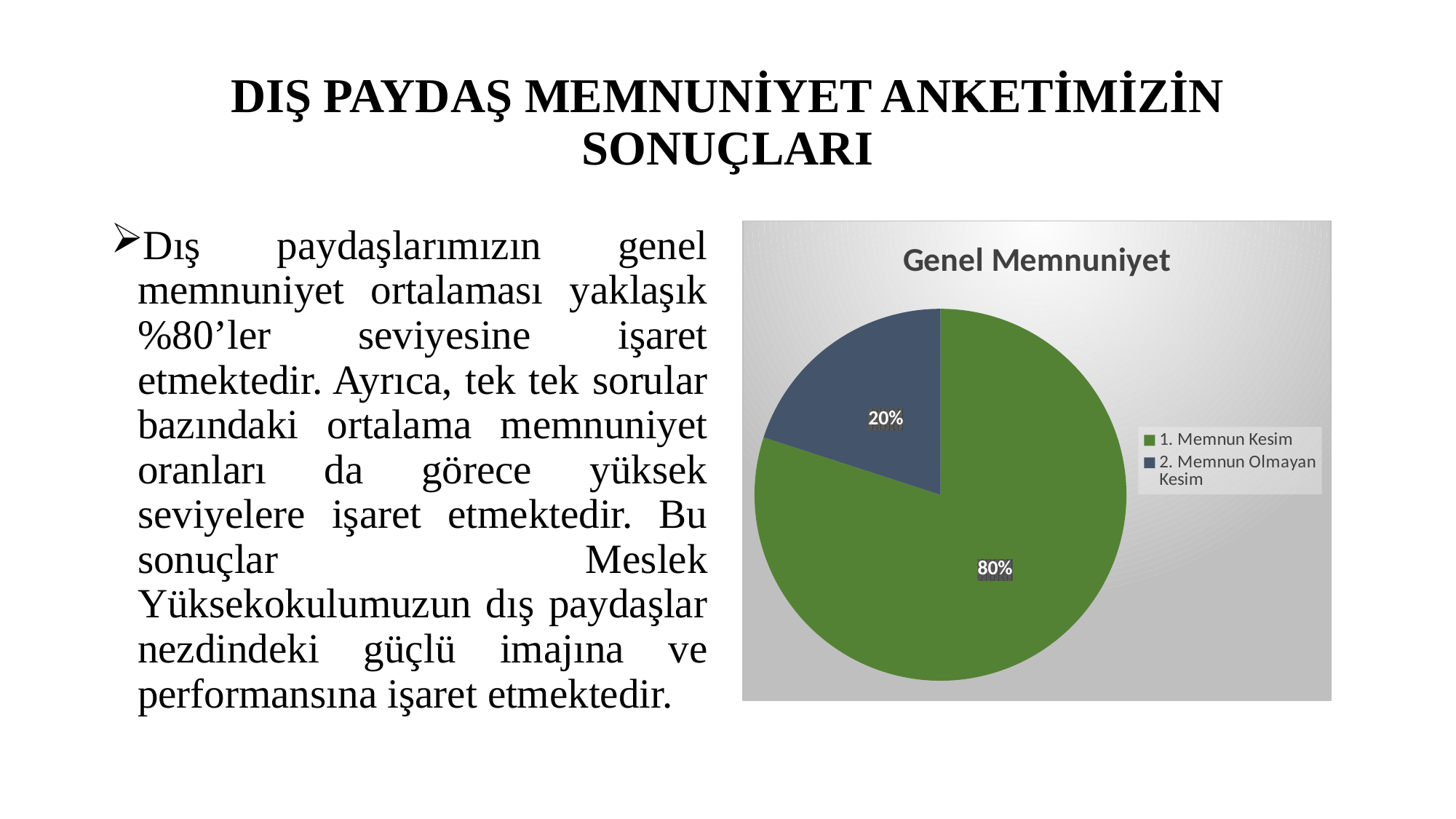
What is the difference in percentage points between '1. Memnun Kesim' and '2. Memnun Olmayan Kesim'? 60% How many entries does the legend list? 2 What share of the pie does '1. Memnun Kesim' represent? 80% What colour is the slice for '1. Memnun Kesim'? green What share of the pie does '2. Memnun Olmayan Kesim' represent? 20% What type of chart is shown on the slide? pie chart What is the title of the chart? Genel Memnuniyet Which category has the largest slice of the pie? 1. Memnun Kesim Which category has the smallest slice of the pie? 2. Memnun Olmayan Kesim How many categories does the pie chart show? 2 Which is larger, the slice for '1. Memnun Kesim' or the slice for '2. Memnun Olmayan Kesim'? 1. Memnun Kesim